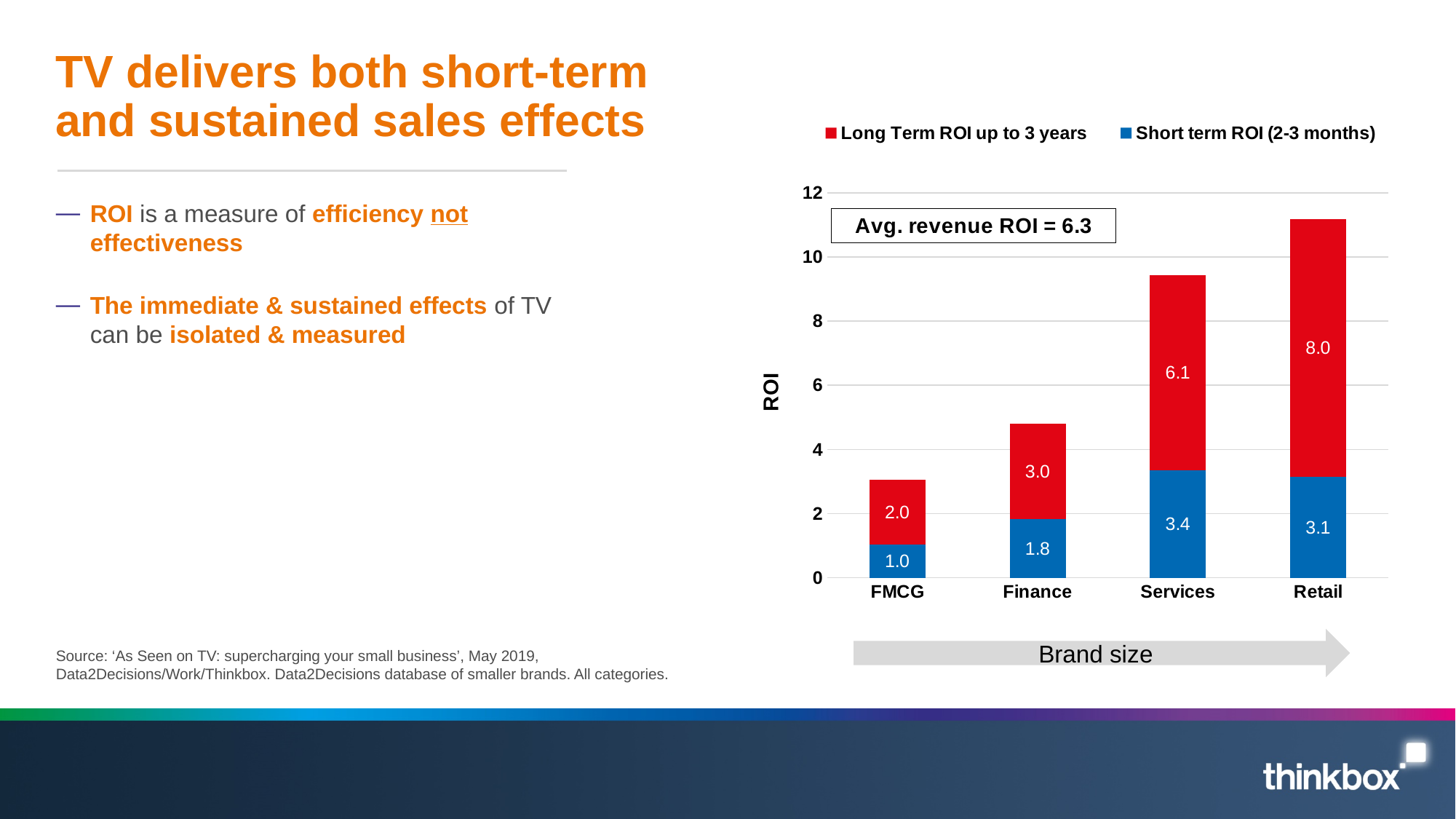
What is the difference between the Long Term ROI up to 3 years for Retail and for Services? 1.9 What is the Long Term ROI up to 3 years value for Retail? 8.0 Which category has the lowest Short term ROI (2-3 months)? FMCG Which is larger: the Short term ROI (2-3 months) for Services or for Retail? Services What kind of chart is shown on the slide? Stacked bar chart What is the total ROI of the stacked bar for Retail? 11.1 What is the Short term ROI (2-3 months) value for Services? 3.4 Which category has the highest Long Term ROI up to 3 years? Retail How many series does the legend list? 2 What is the total ROI of the stacked bar for Finance? 4.8 How many categories are shown on the x axis? 4 What is the Long Term ROI up to 3 years value for FMCG? 2.0